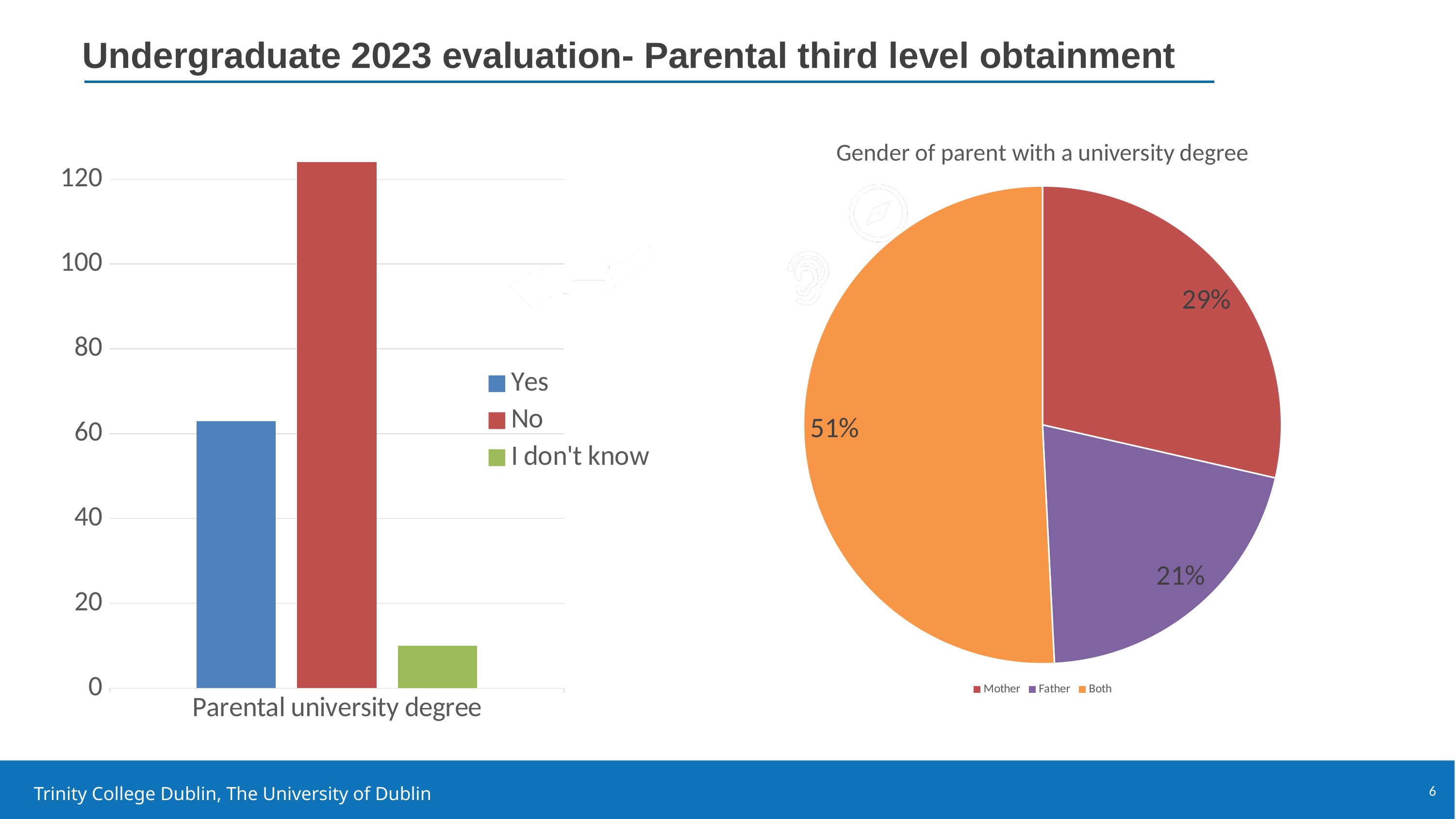
In the bar chart on the left, which series has the highest bar? No In the bar chart on the left, which series has the lowest bar? I don't know In the pie chart 'Gender of parent with a university degree', which slice is the largest? Both In the pie chart 'Gender of parent with a university degree', what is the difference between the Mother share and the Father share? 8% In the bar chart on the left, is the value for No greater or less than 120? greater In the pie chart 'Gender of parent with a university degree', what share is labelled for Father? 21% In the bar chart on the left, is the value for I don't know greater or less than 20? less In the bar chart on the left, is the value for Yes greater or less than 60? greater In the pie chart 'Gender of parent with a university degree', what share is labelled for Mother? 29% What kind of chart is the chart on the left of the slide? bar chart How many series does the legend of the bar chart on the left list? 3 In the bar chart on the left, which is larger, the value for Yes or the value for No? No